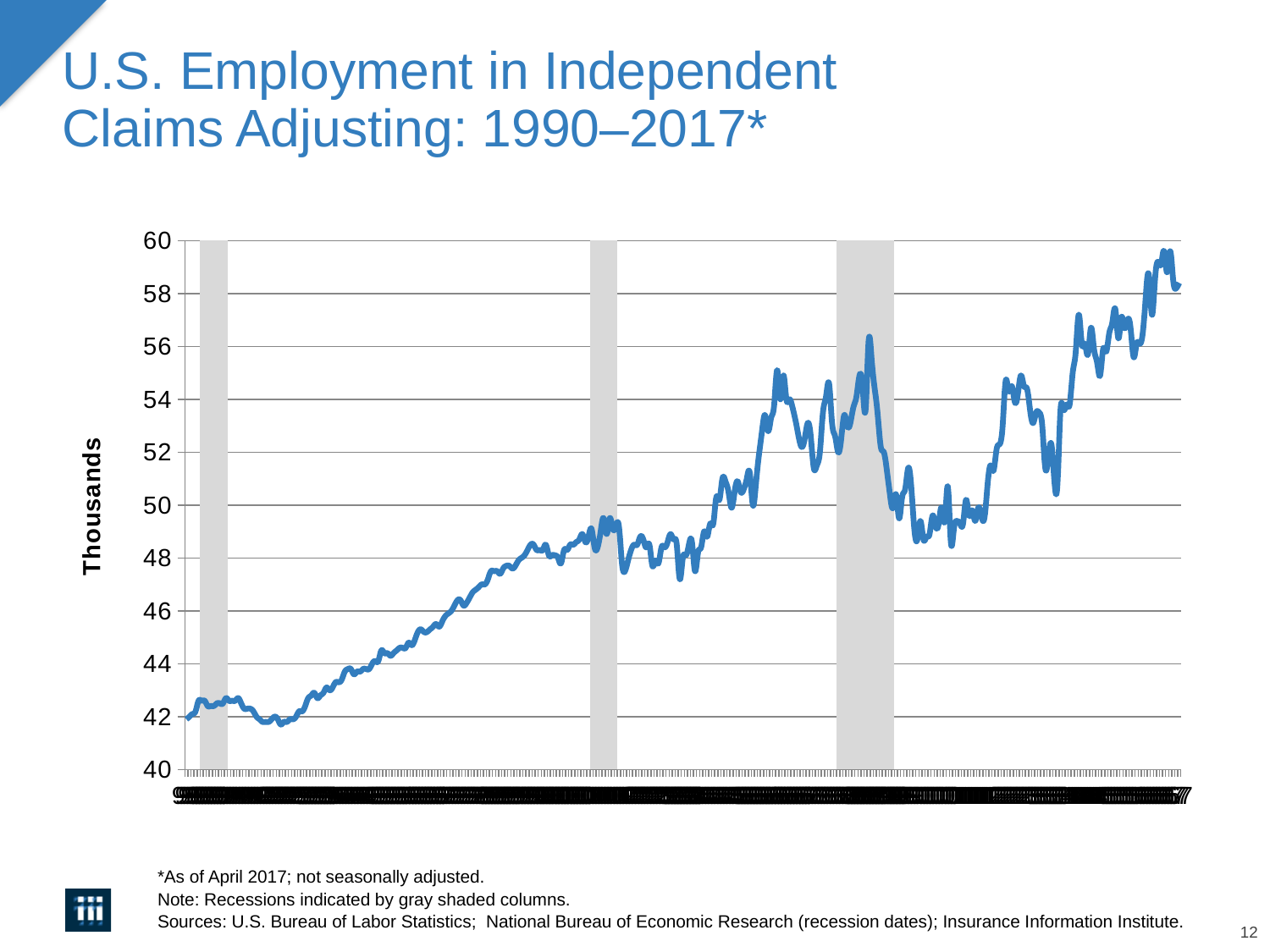
Is the value at the right end of the line (end of the series) greater or less than 56? greater Is the value at the left end of the line (start of the series) greater or less than 44? less Is the highest point reached by the line greater or less than 58? greater Is the value at the right end of the line greater or less than the value at the left end of the line? greater What is the lowest value shown on the vertical axis? 40 What kind of chart is shown on the slide? line chart Overall, do the values rise or fall from the left end of the x axis to the right end? rise What is the label on the vertical axis of the chart? Thousands How many gray shaded recession columns appear on the chart? 3